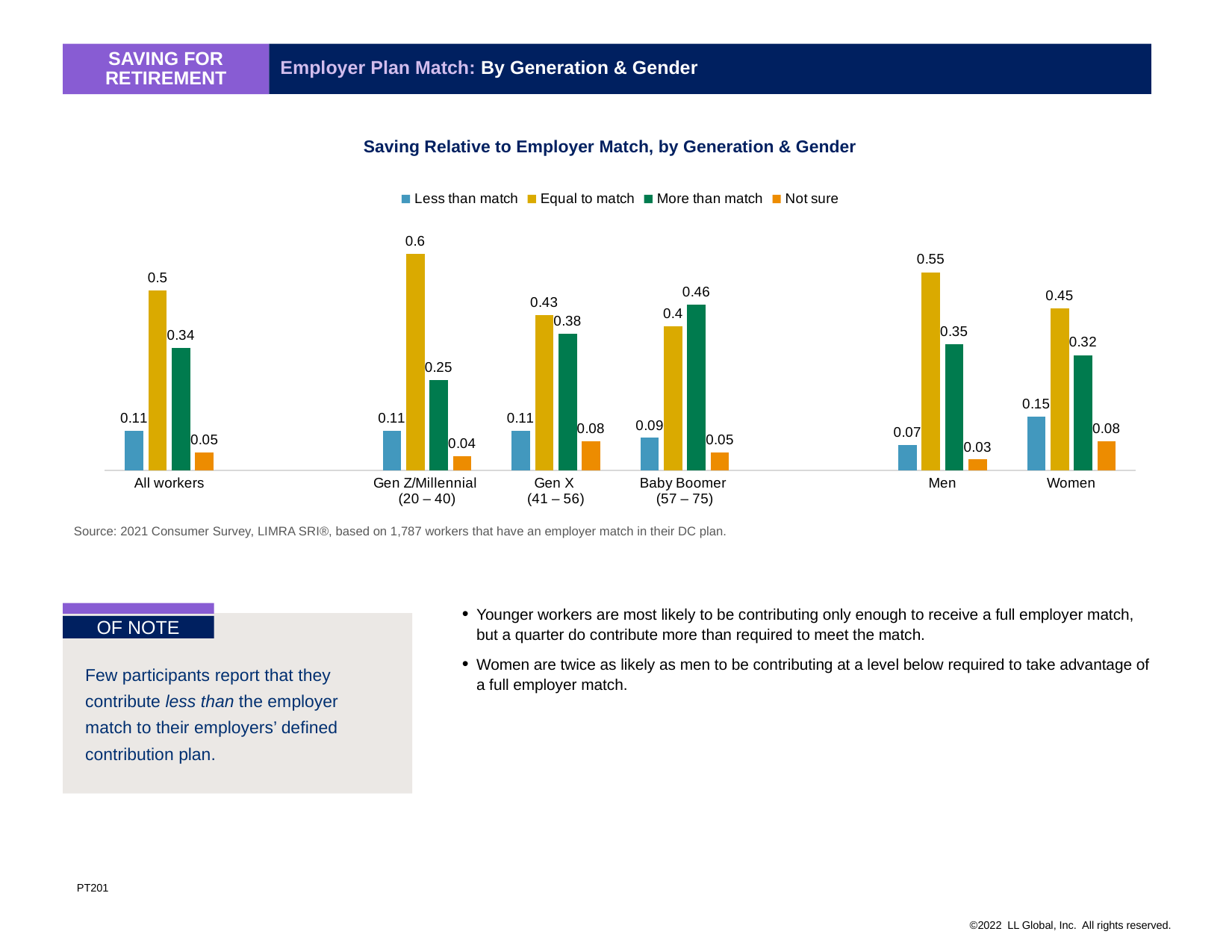
How many categories are shown on the x axis? 6 What is the difference between the "Less than match" values for Women and Men? 0.08 What is the value for "Equal to match" for Gen Z/Millennial (20 – 40)? 0.6 Which category has the highest value for "Equal to match"? Gen Z/Millennial (20 – 40) What is the title of the chart? Saving Relative to Employer Match, by Generation & Gender What is the value for "Less than match" for Women? 0.15 How many series does the legend list? 4 What kind of chart is shown on the slide? Bar chart What is the value for "Not sure" for Men? 0.03 Which is larger for Baby Boomer (57 – 75): "Equal to match" or "More than match"? More than match Which category has the lowest value for "Less than match"? Men What is the value for "More than match" for Baby Boomer (57 – 75)? 0.46